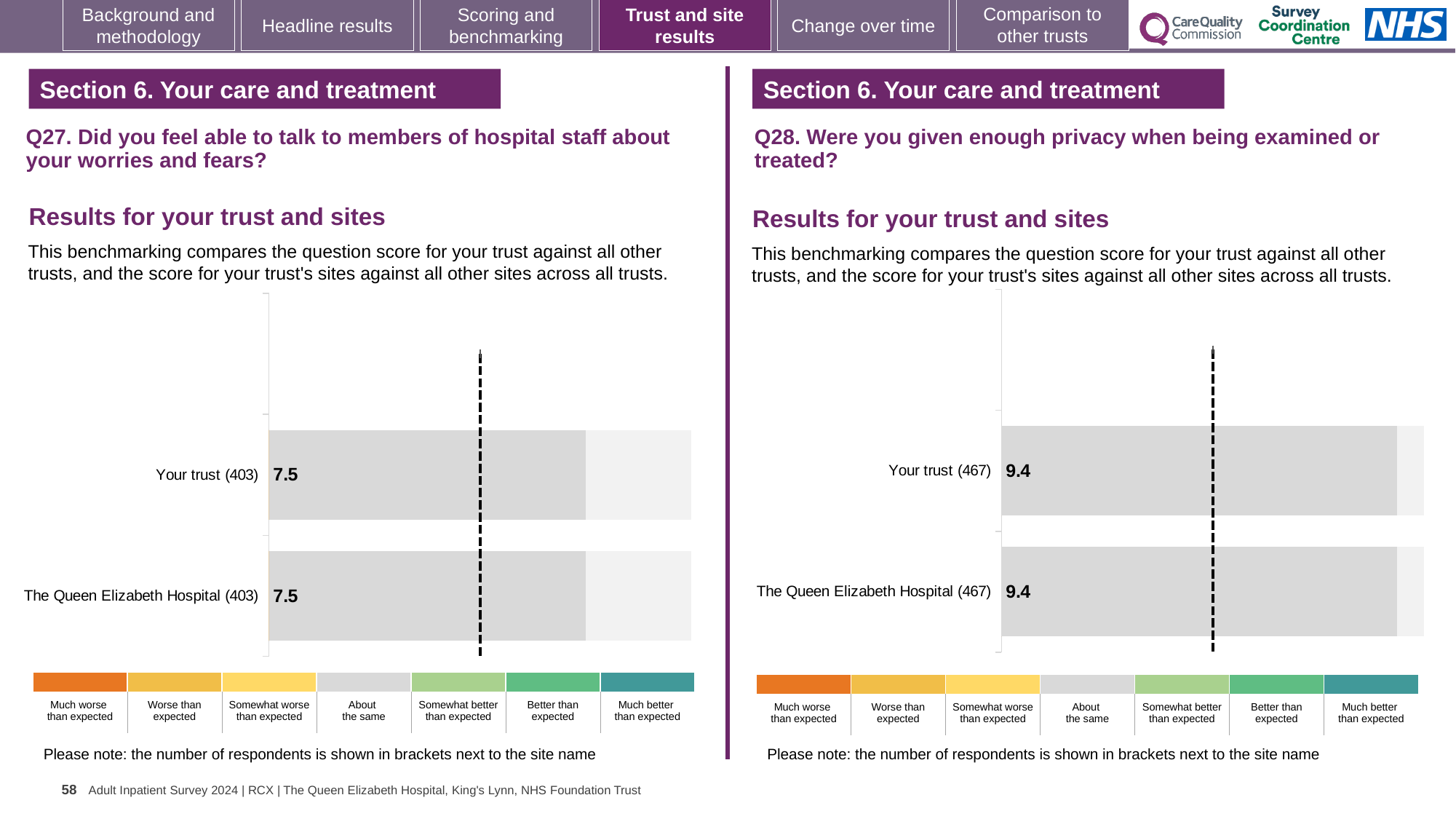
On the Q28 chart (right), what is the score for Your trust? 9.4 On the Q28 chart (right), what is the score for The Queen Elizabeth Hospital? 9.4 Is the score for Your trust on the Q28 chart (right) larger or smaller than the score for Your trust on the Q27 chart (left)? Larger On the Q28 chart (right), what is the difference between the score for Your trust and the score for The Queen Elizabeth Hospital? 0 On the Q28 chart (right), how many respondents are shown in brackets for The Queen Elizabeth Hospital? 467 On the Q27 chart (left), what is the score for Your trust? 7.5 On the Q27 chart (left), what is the difference between the score for Your trust and the score for The Queen Elizabeth Hospital? 0 On the Q27 chart (left), what is the score for The Queen Elizabeth Hospital? 7.5 What kind of chart is the Q27 chart (left)? Bar chart On the Q27 chart (left), how many respondents are shown in brackets for Your trust? 403 How many bars are plotted on the Q28 chart (right)? 2 How many bars are plotted on the Q27 chart (left)? 2